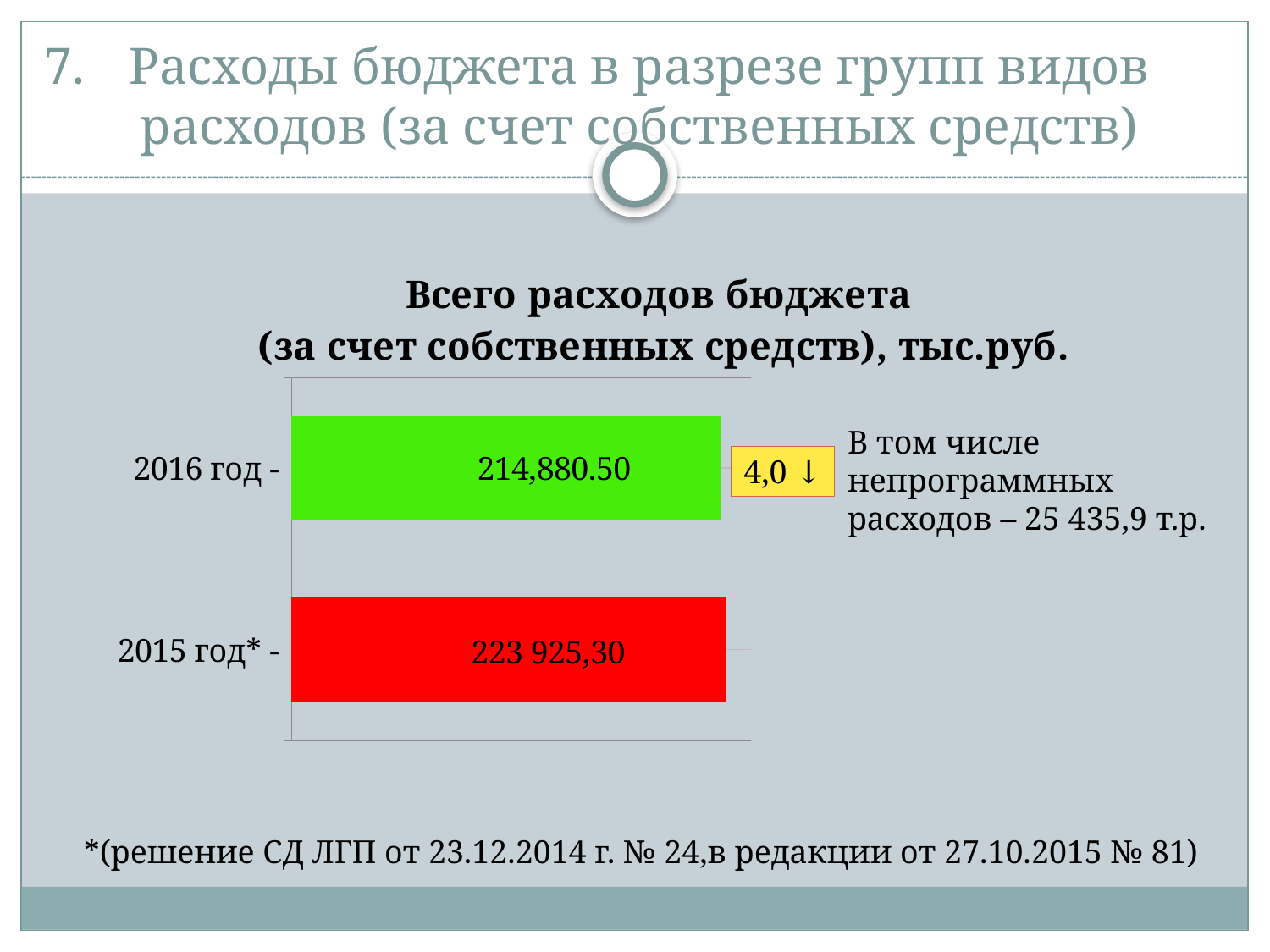
How many bars are shown in the chart? 2 According to the note beside the chart, what is the amount of непрограммных расходов in 2016? 25 435,9 т.р. What percentage change is shown in the yellow label next to the 2016 год bar? 4,0 ↓ What is the value for 2015 год* in the chart? 223 925,30 What is the value for 2016 год in the chart? 214,880.50 What is the title of the chart? Всего расходов бюджета (за счет собственных средств), тыс.руб. Which year has the lower total budget expenditure in the chart? 2016 год Is the value for 2016 год larger or smaller than the value for 2015 год*? smaller Which year has the higher total budget expenditure in the chart? 2015 год* What colour is the bar for 2016 год? green What type of chart is shown on the slide? bar chart By how much does the 2015 год* value exceed the 2016 год value? 9 044,80